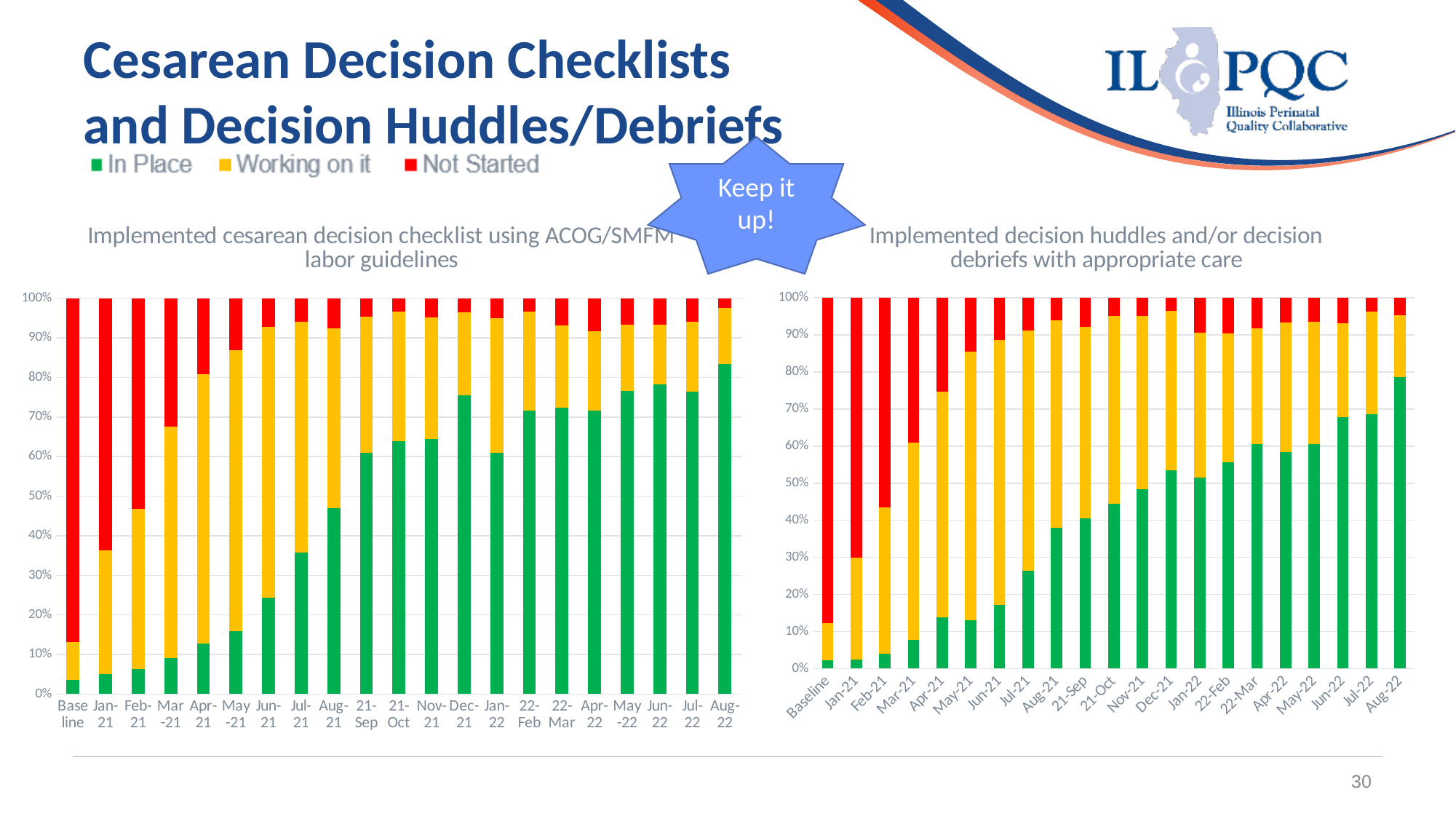
In the left chart (cesarean decision checklist), how many time-period categories are shown on the x axis? 21 What kind of chart is used on the left, titled 'Implemented cesarean decision checklist using ACOG/SMFM labor guidelines'? Stacked bar chart In the right chart (decision huddles/debriefs), is the 'In Place' value for Dec-21 greater or less than 50%? greater In the right chart (decision huddles/debriefs), is the 'Not Started' share for Baseline greater or less than 80%? greater In the right chart (decision huddles/debriefs), which period has the highest 'In Place' value? Aug-22 In the right chart (decision huddles/debriefs), does the 'In Place' share generally rise or fall from Baseline to Aug-22? Rise In the right chart (decision huddles and/or decision debriefs), how many time-period categories are shown on the x axis? 21 In the left chart (cesarean decision checklist), which period has the highest 'In Place' value? Aug-22 How many series does the shared legend list? 3 In the left chart (cesarean decision checklist), is the 'In Place' value for Baseline greater or less than 10%? less In the left chart (cesarean decision checklist), which is larger, the 'In Place' value for Dec-21 or for Jan-22? Dec-21